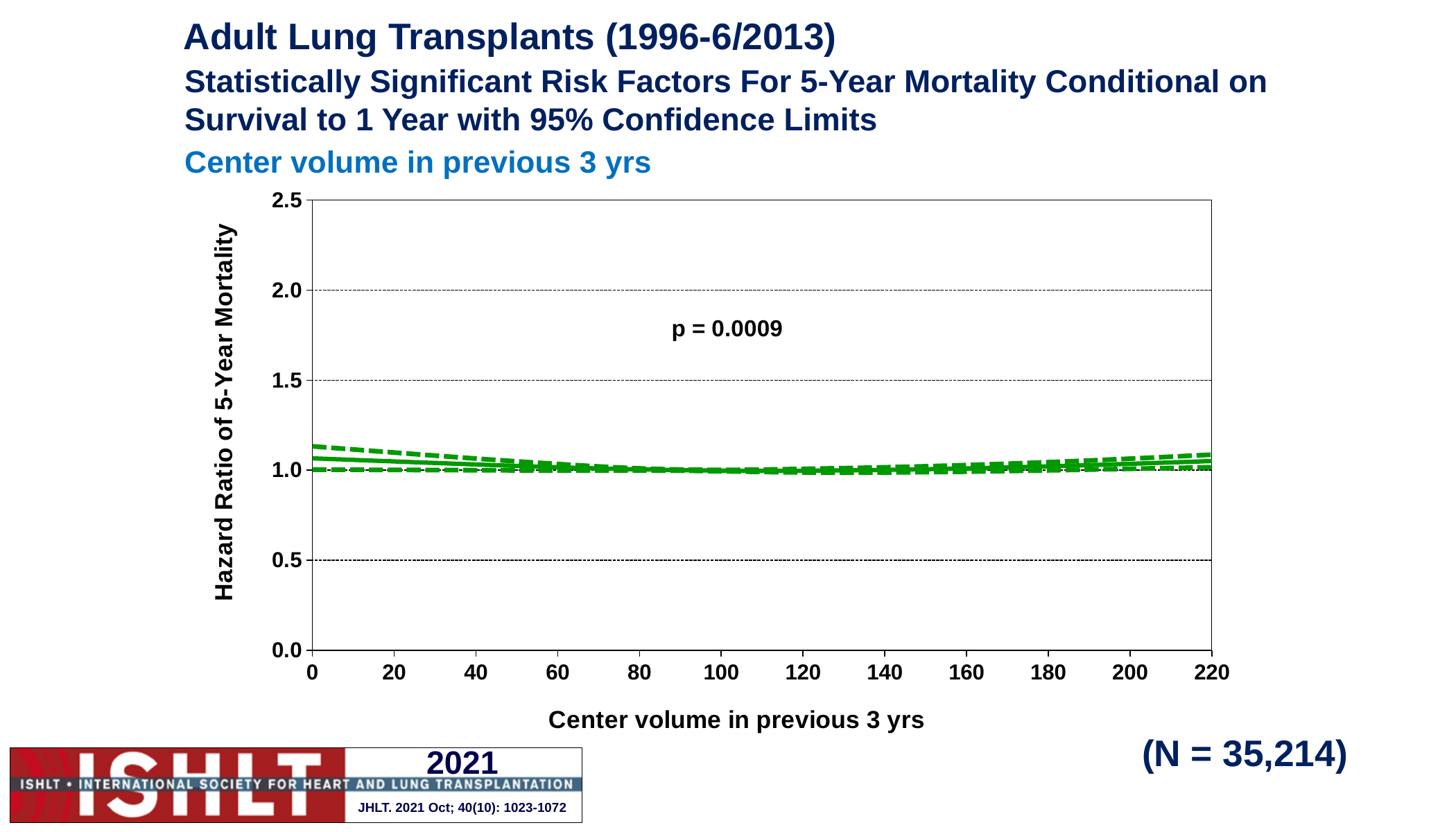
What is the label of the y axis? Hazard Ratio of 5-Year Mortality What is the p-value printed on the chart? p = 0.0009 What is the sample size (N) shown on the slide? N = 35,214 Is the hazard ratio at a center volume of 220 greater or less than 0.5? greater Does the solid hazard ratio line rise or fall as center volume increases from 0 to 100? falls Is the hazard ratio at a center volume of 0 greater or less than 1.5? less Is the hazard ratio at a center volume of 100 greater or less than 2.0? less What kind of chart is shown on the slide? line chart What is the highest value shown on the x axis? 220 How many lines are plotted on the chart (including the confidence limit lines)? 3 Does the solid hazard ratio line rise or fall as center volume increases from 120 to 220? rises